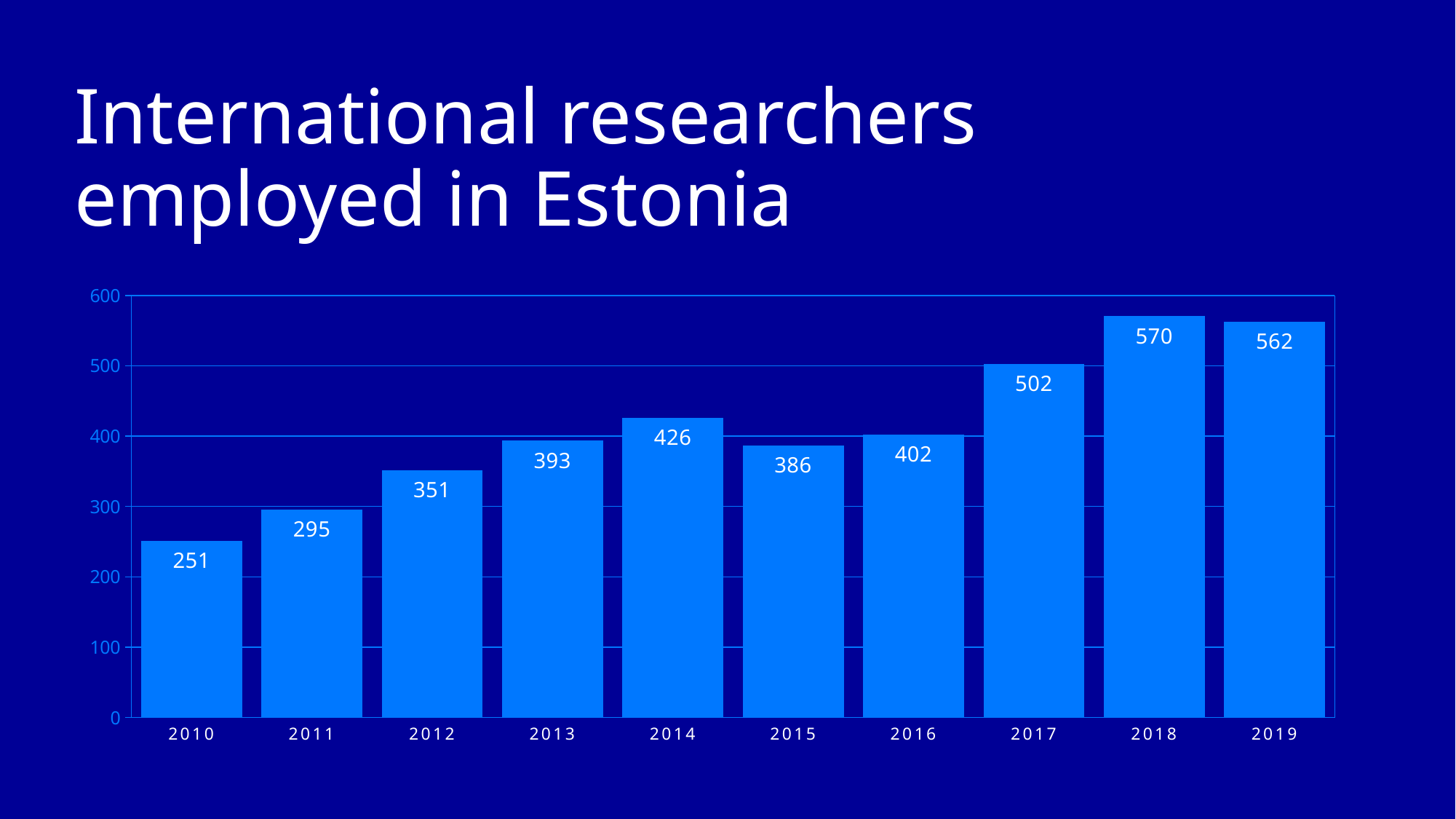
Which year has the highest value? 2018 Is the value for 2013 greater or less than 400? less What is the difference between the values for 2017 and 2010? 251 What is the difference between the values for 2018 and 2019? 8 Which year has the lowest value? 2010 What is the value for 2015? 386 Which is larger, the value for 2014 or the value for 2016? 2014 What is the title of the slide? International researchers employed in Estonia How many years are shown on the x axis? 10 What is the value for 2010? 251 What is the value for 2017? 502 What kind of chart is shown on the slide? bar chart